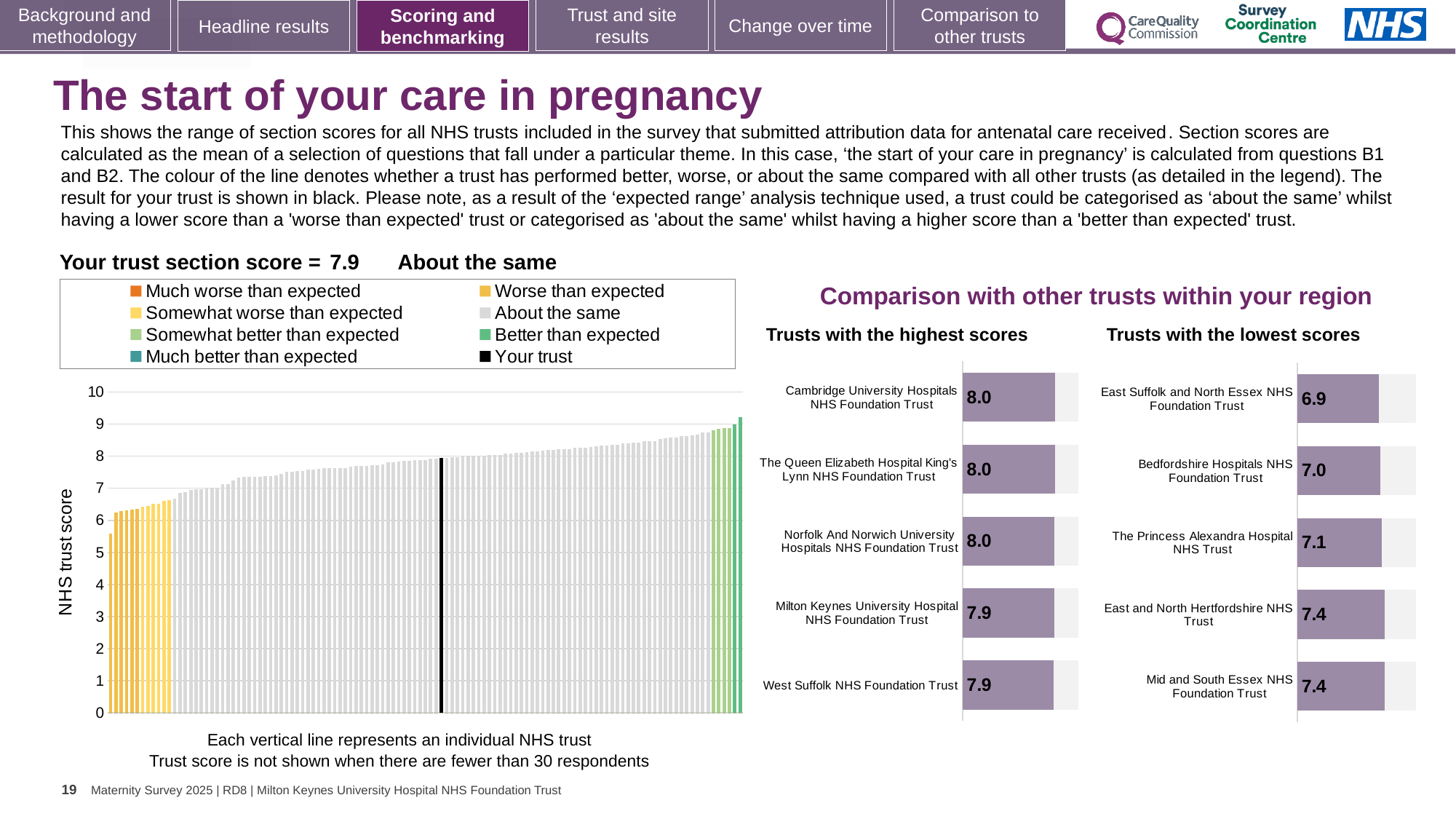
In the 'Trusts with the lowest scores' chart, which trust has the lowest score? East Suffolk and North Essex NHS Foundation Trust In the 'Trusts with the highest scores' chart, what is the score for Cambridge University Hospitals NHS Foundation Trust? 8.0 How many entries does the legend above the large chart on the left list? 8 In the 'Trusts with the highest scores' chart, what is the score for West Suffolk NHS Foundation Trust? 7.9 In the large chart on the left, what is the label on the vertical axis? NHS trust score In the 'Trusts with the lowest scores' chart, what is the difference between the scores for Mid and South Essex NHS Foundation Trust and East Suffolk and North Essex NHS Foundation Trust? 0.5 How many trusts are shown in the 'Trusts with the lowest scores' chart? 5 How many trusts are shown in the 'Trusts with the highest scores' chart? 5 In the 'Trusts with the lowest scores' chart, what is the score for Bedfordshire Hospitals NHS Foundation Trust? 7.0 In the 'Trusts with the highest scores' chart, what is the difference between the scores for Norfolk And Norwich University Hospitals NHS Foundation Trust and Milton Keynes University Hospital NHS Foundation Trust? 0.1 In the 'Trusts with the lowest scores' chart, which has the higher score: Bedfordshire Hospitals NHS Foundation Trust or The Princess Alexandra Hospital NHS Trust? The Princess Alexandra Hospital NHS Trust What kind of chart is the large chart on the left of the slide? bar chart